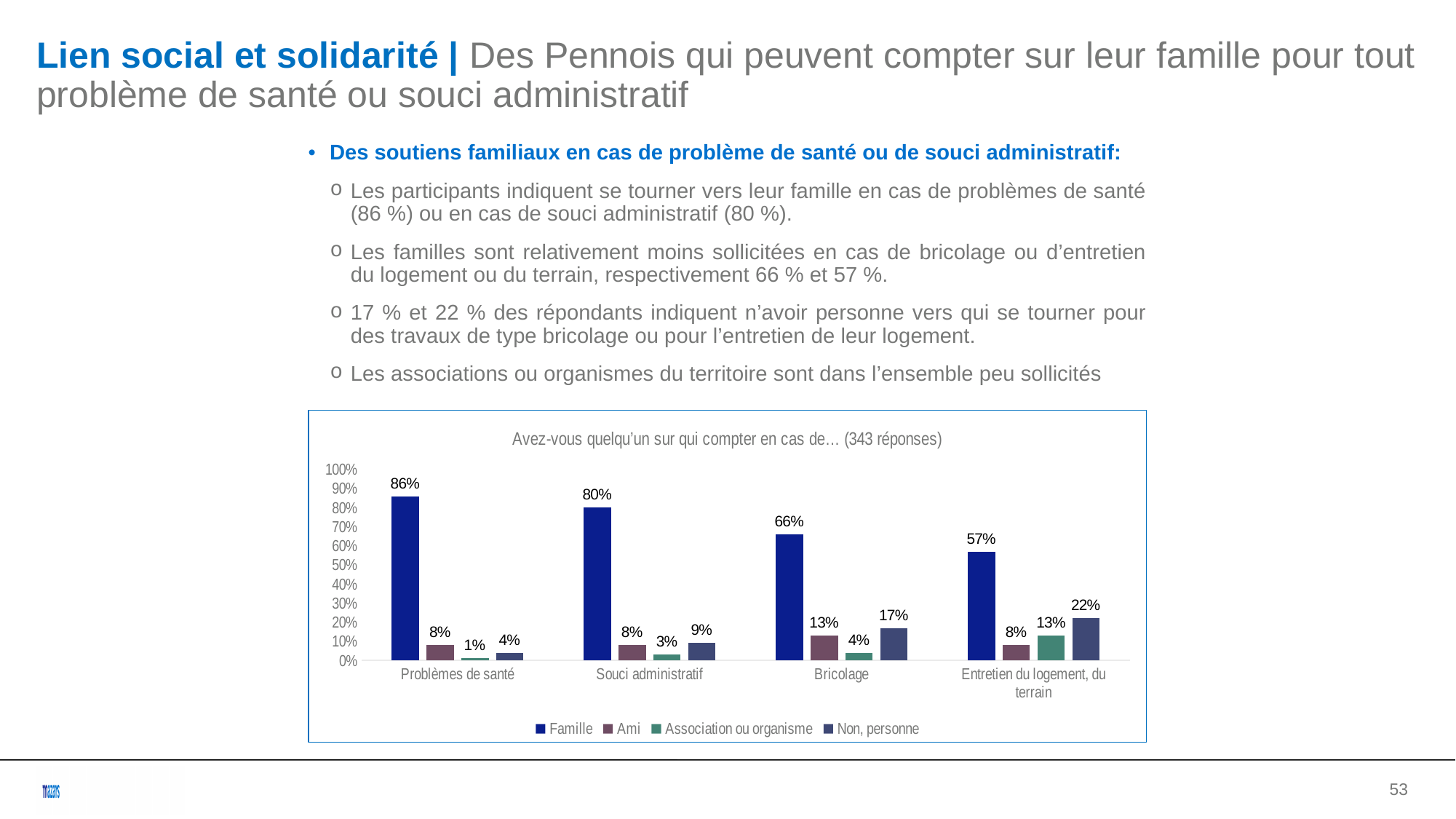
How many series does the legend list? 4 What is the value for Ami in the Souci administratif category? 8% What is the difference between the Famille values for Problèmes de santé and Souci administratif? 6% In which category is the Famille value the lowest? Entretien du logement, du terrain What is the title of the chart? Avez-vous quelqu'un sur qui compter en cas de… (343 réponses) In which category is the Non, personne value the highest? Entretien du logement, du terrain What kind of chart is shown on the slide? Bar chart What is the value for Famille in the Problèmes de santé category? 86% How many categories are shown on the x axis? 4 Which is larger: the Non, personne value for Bricolage or for Souci administratif? Bricolage What is the value for Non, personne in the Entretien du logement, du terrain category? 22% What is the value for Association ou organisme in the Bricolage category? 4%